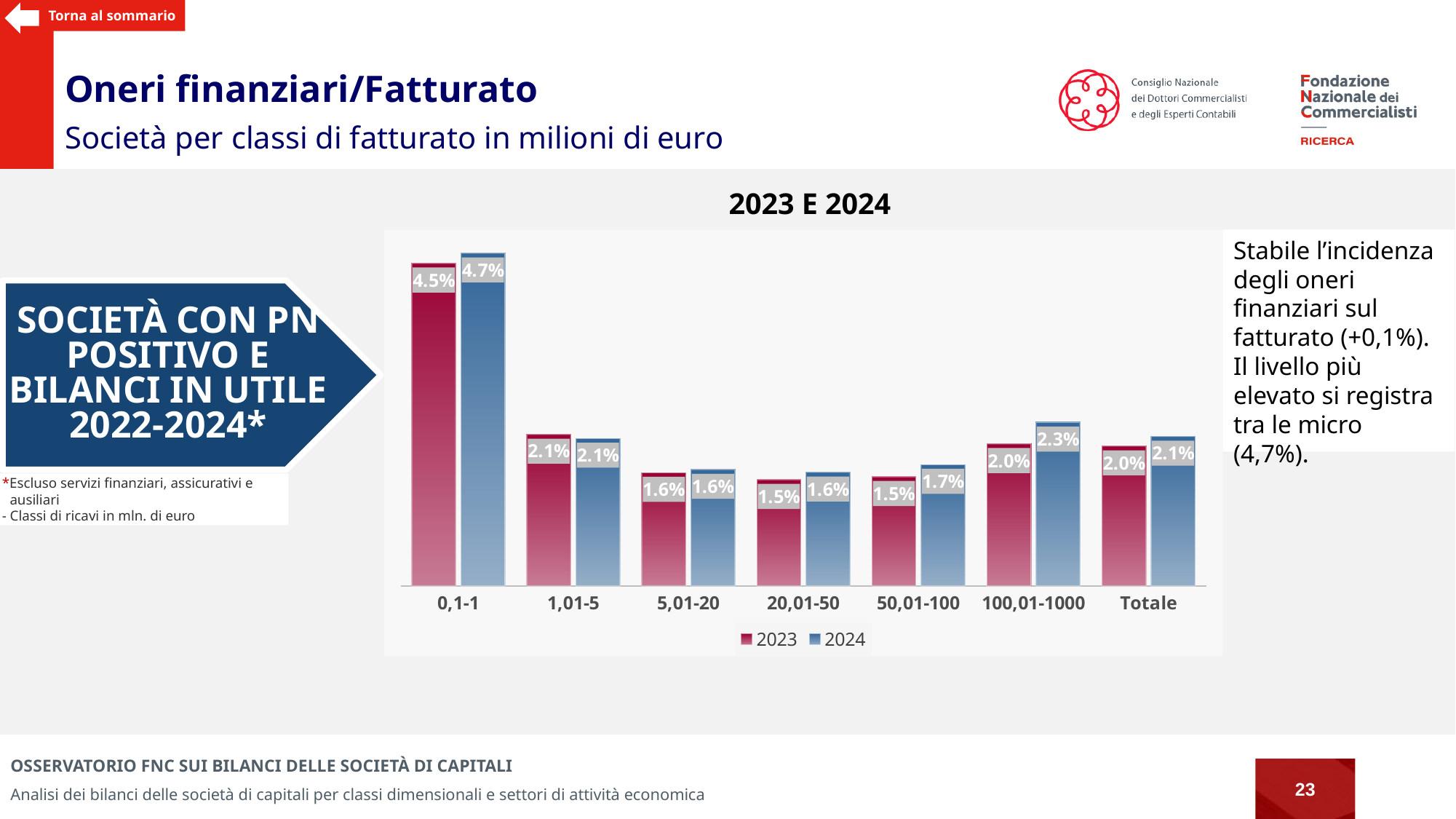
What kind of chart is shown? Bar chart What is the 2024 value for Totale? 2.1% What is the title shown above the chart? 2023 E 2024 Which revenue class has the lowest 2023 value? 20,01-50 and 50,01-100 (both 1.5%) What is the 2024 value for the 0,1-1 revenue class? 4.7% How many revenue classes (categories) are shown on the x axis? 7 What is the 2023 value for the 100,01-1000 revenue class? 2.0% Which revenue class has the highest 2024 value? 0,1-1 What is the 2023 value for the 20,01-50 revenue class? 1.5% What is the difference between the 2024 and 2023 values for the 100,01-1000 class? 0.3% Which is larger for the 50,01-100 class, the 2023 value or the 2024 value? 2024 How many series does the legend list? 2